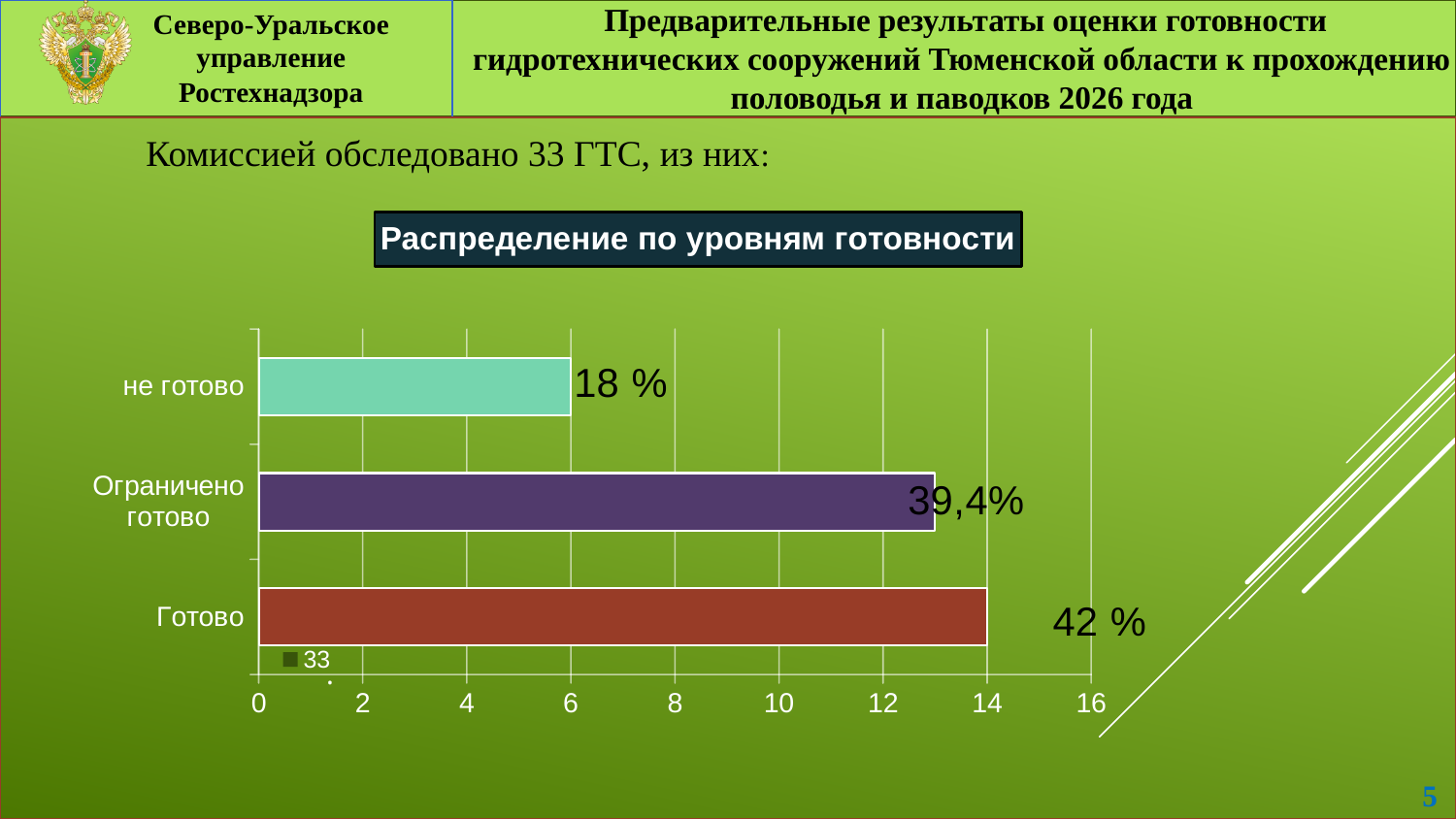
What type of chart is shown on the slide? Bar chart Which bar is longer: 'Готово' or 'не готово'? Готово What percentage label is shown for the 'Готово' bar? 42 % What is the title of the chart? Распределение по уровням готовности Is the bar for 'Ограничено готово' greater or less than 12 on the axis? greater How many categories are shown in the chart? 3 What percentage label is shown for the 'Ограничено готово' bar? 39,4% What is the maximum value shown on the horizontal axis? 16 What percentage label is shown for the 'не готово' bar? 18 % Which category has the shortest bar? не готово Which category has the longest bar? Готово Is the bar for 'не готово' greater or less than 8 on the axis? less